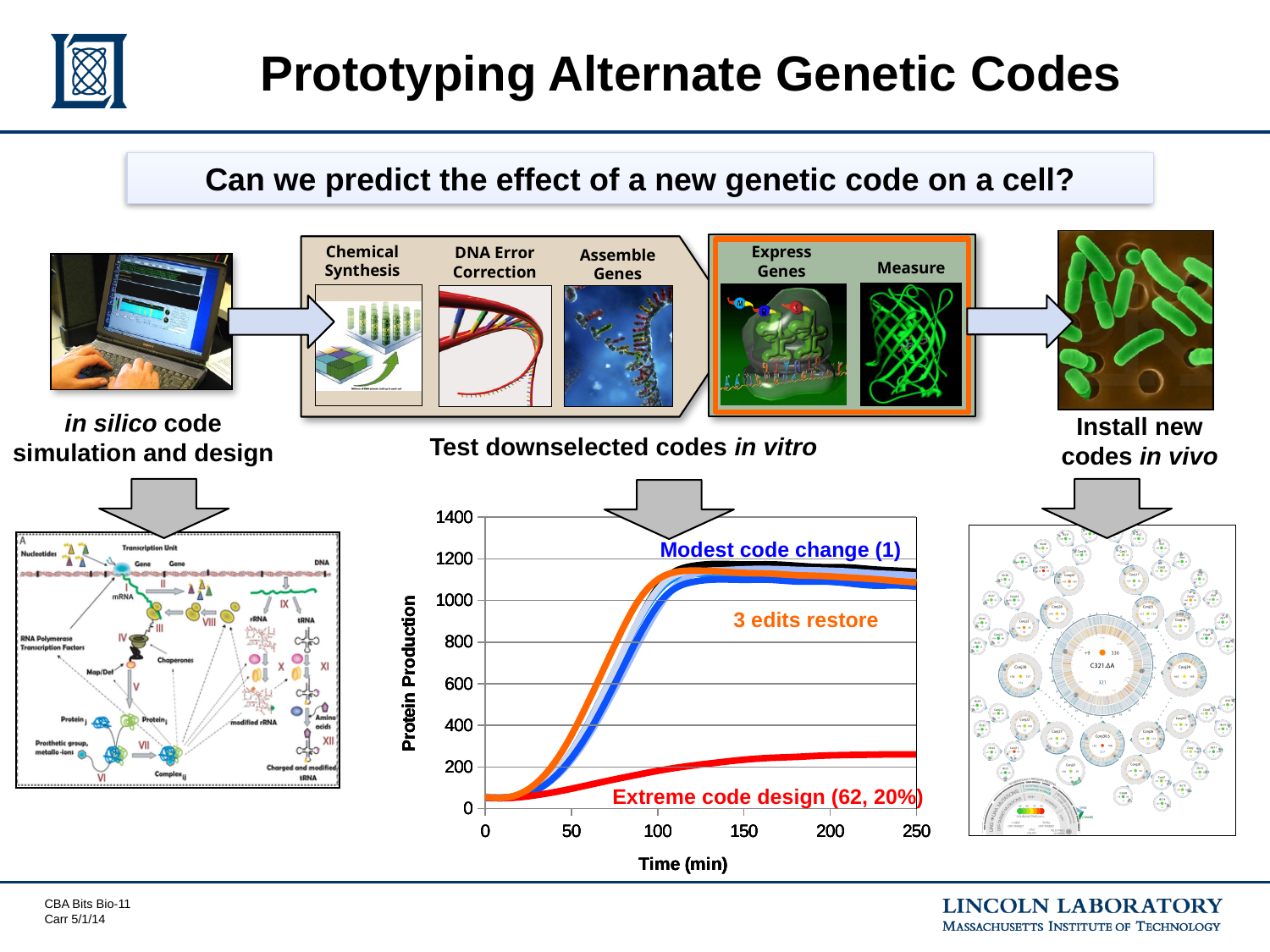
Is the Protein Production value for Extreme code design (62, 20%) at 250 min greater or less than 400? less How many labelled curves are annotated on the Protein Production chart? 3 What is the label of the y axis of the Protein Production chart? Protein Production What is the label of the x axis of the Protein Production chart? Time (min) At 250 min, which has higher Protein Production: Modest code change (1) or Extreme code design (62, 20%)? Modest code change (1) Does the Extreme code design (62, 20%) curve rise or fall as Time increases from 0 to 250 min? rise Is the Protein Production value for Extreme code design (62, 20%) at 250 min greater or less than 200? greater What kind of chart is shown in the centre of the slide? line chart Is the Protein Production value for 3 edits restore at 250 min greater or less than 1000? greater Which curve on the Protein Production chart has the lowest value at 250 min? Extreme code design (62, 20%)